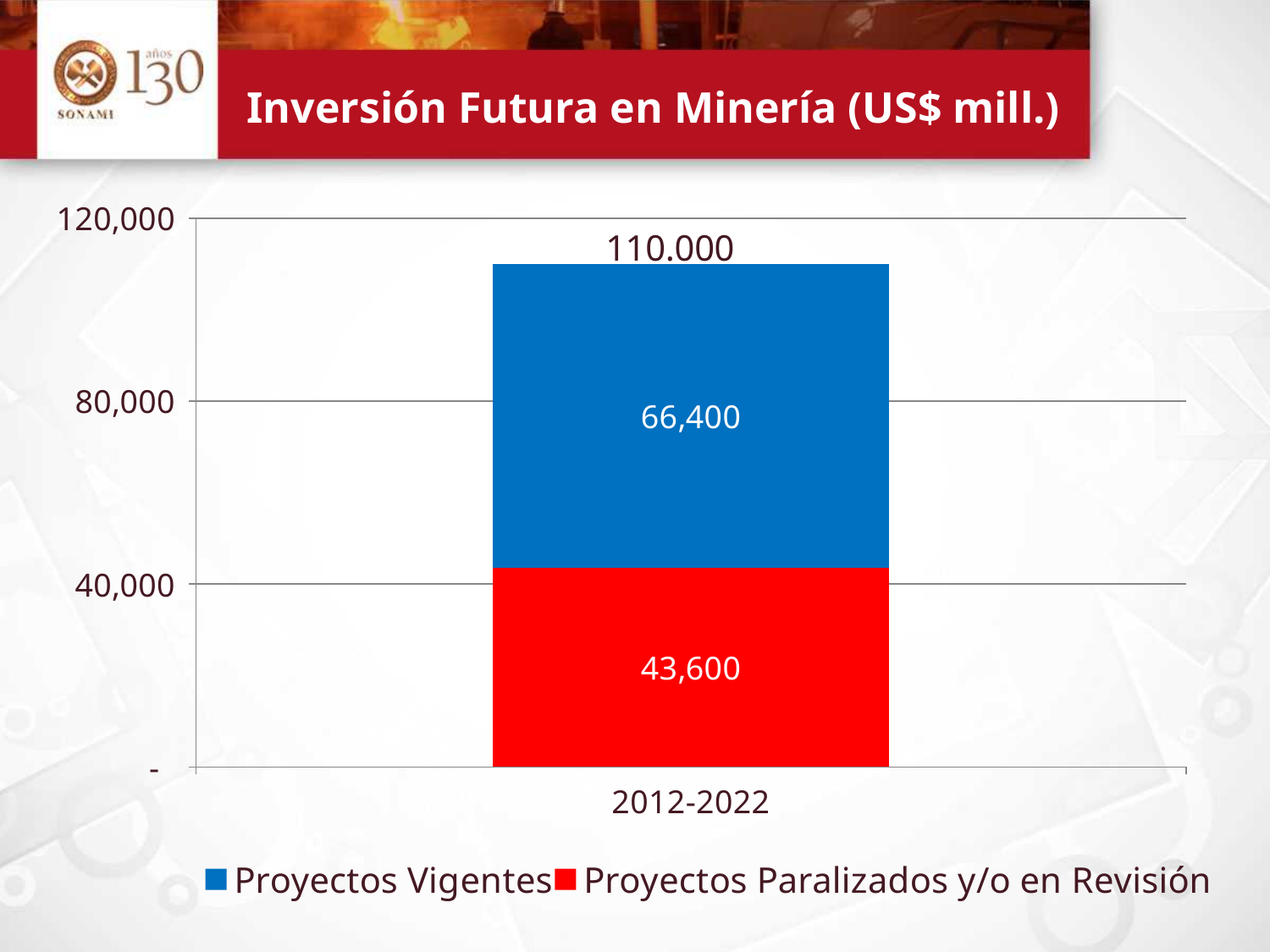
What is the difference between the Proyectos Vigentes value and the Proyectos Paralizados y/o en Revisión value? 22,800 What kind of chart is shown on the slide? Stacked bar chart How many categories are shown on the x axis? 1 Is the total of the 2012-2022 bar greater or less than 80,000? greater Which series has the smallest value in the chart? Proyectos Paralizados y/o en Revisión Which series has the larger value: Proyectos Vigentes or Proyectos Paralizados y/o en Revisión? Proyectos Vigentes What is the value for Proyectos Vigentes in the 2012-2022 bar? 66,400 What is the title of the chart? Inversión Futura en Minería (US$ mill.) What is the value for Proyectos Paralizados y/o en Revisión in the 2012-2022 bar? 43,600 Is the value for Proyectos Paralizados y/o en Revisión greater or less than 40,000? greater What is the total of the stacked bar for 2012-2022, as printed on the slide? 110.000 How many series does the legend list? 2